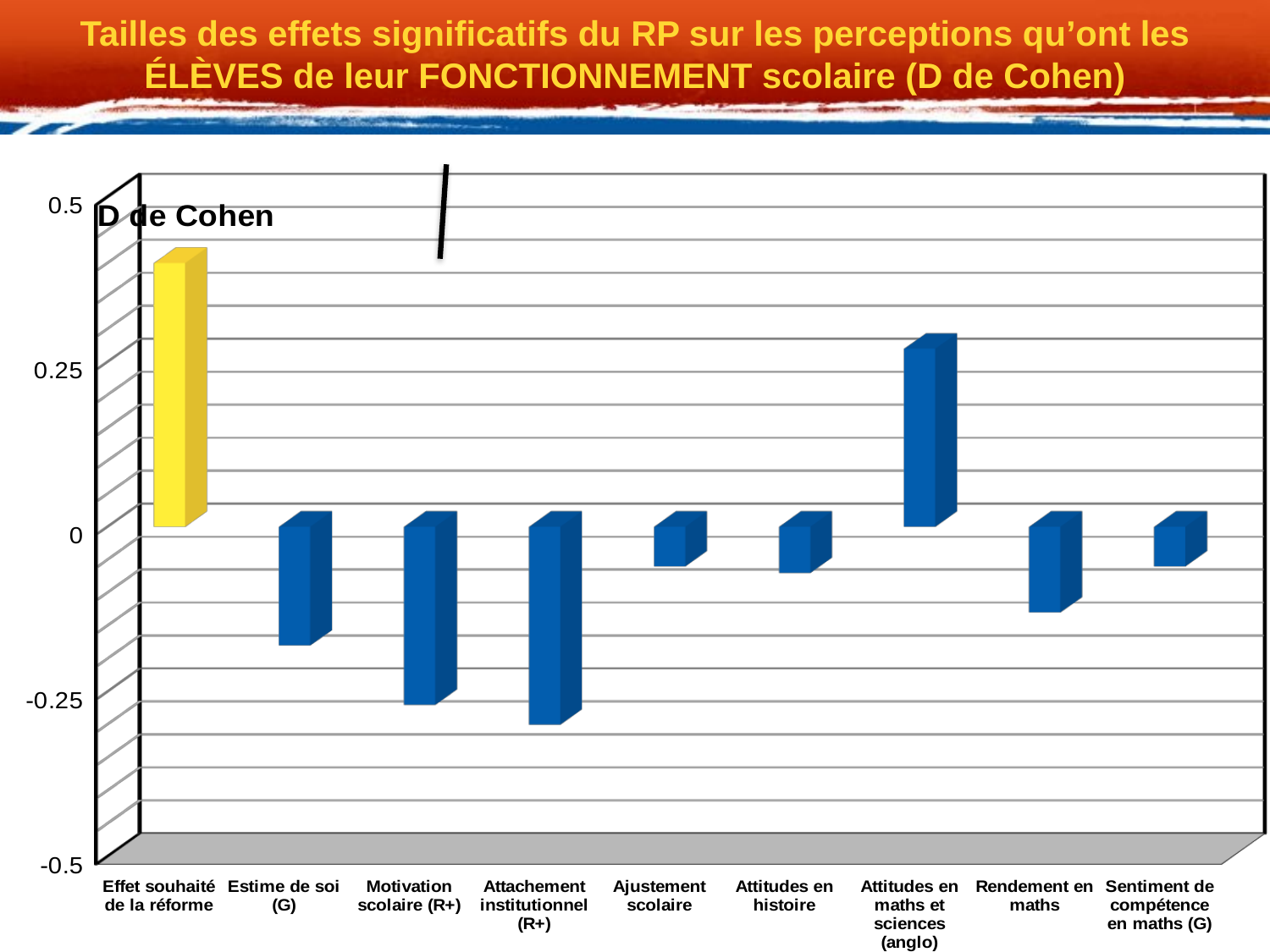
What colour is the bar for Effet souhaité de la réforme? yellow What kind of chart is shown on the slide? bar chart Is the value for Rendement en maths greater or less than 0? less How many categories have a negative value? 7 How many categories are plotted on the x axis? 9 Is the value for Attitudes en maths et sciences (anglo) greater or less than 0? greater Which category has the lowest value? Attachement institutionnel (R+) Is the value for Attachement institutionnel (R+) greater or less than -0.25? less Which is larger, the value for Attitudes en maths et sciences (anglo) or the value for Ajustement scolaire? Attitudes en maths et sciences (anglo) Which category has the highest value? Effet souhaité de la réforme